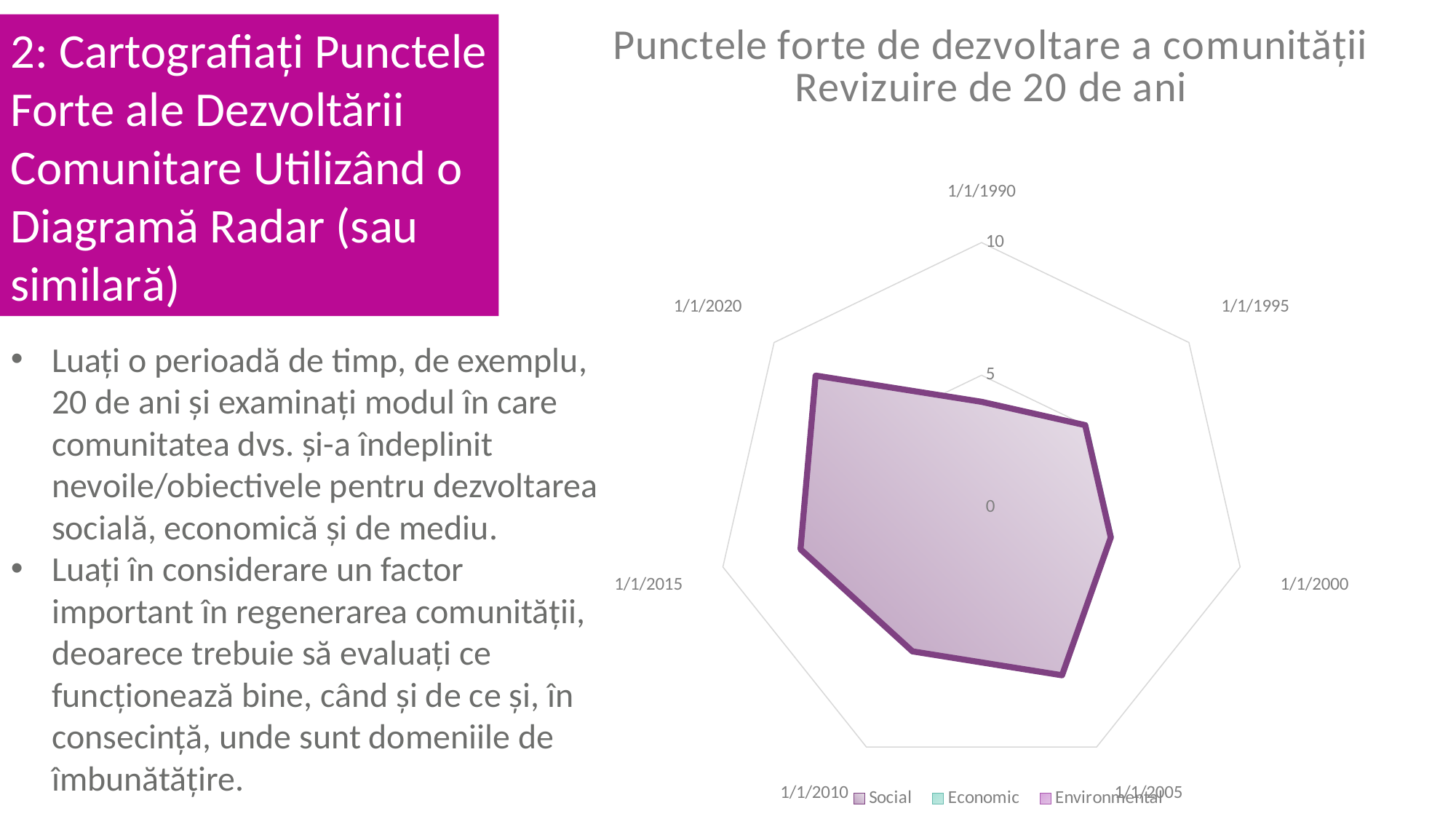
Is the plotted value for 1/1/2005 greater or less than 5? greater Which has the larger plotted value, 1/1/2015 or 1/1/1995? 1/1/2015 How many categories (dates) are plotted around the radar chart? 7 How many series does the chart legend list? 3 Which series are listed in the chart legend? Social, Economic, Environmental Is the plotted value for 1/1/1990 greater or less than 10? less Which has the larger plotted value, 1/1/2020 or 1/1/1990? 1/1/2020 What kind of chart is shown on the slide? radar chart Is the plotted value for 1/1/2010 greater or less than 5? greater What is the title of the chart? Punctele forte de dezvoltare a comunității Revizuire de 20 de ani